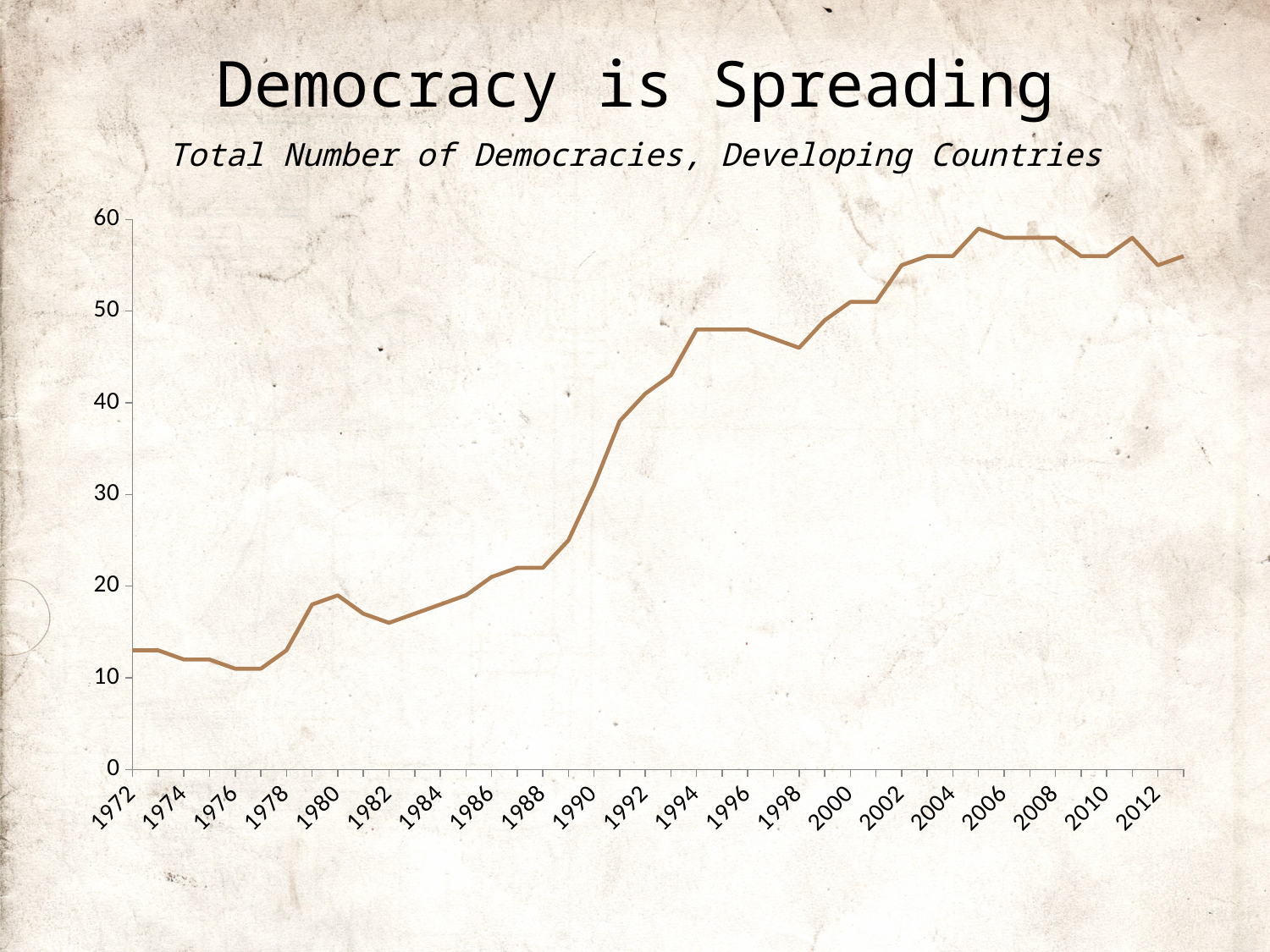
Overall, do the values rise or fall from 1972 to 2012? rise What kind of chart is shown on the slide? line chart Which year has the highest value on the chart? 2005 Is the value for 1990 greater or less than 20? greater Is the value for 2002 greater or less than 50? greater Which is larger, the value for 1994 or the value for 1998? 1994 What is the subtitle describing the data plotted in the chart? Total Number of Democracies, Developing Countries Is the value for 1972 greater or less than 10? greater How many year labels are shown on the x axis? 21